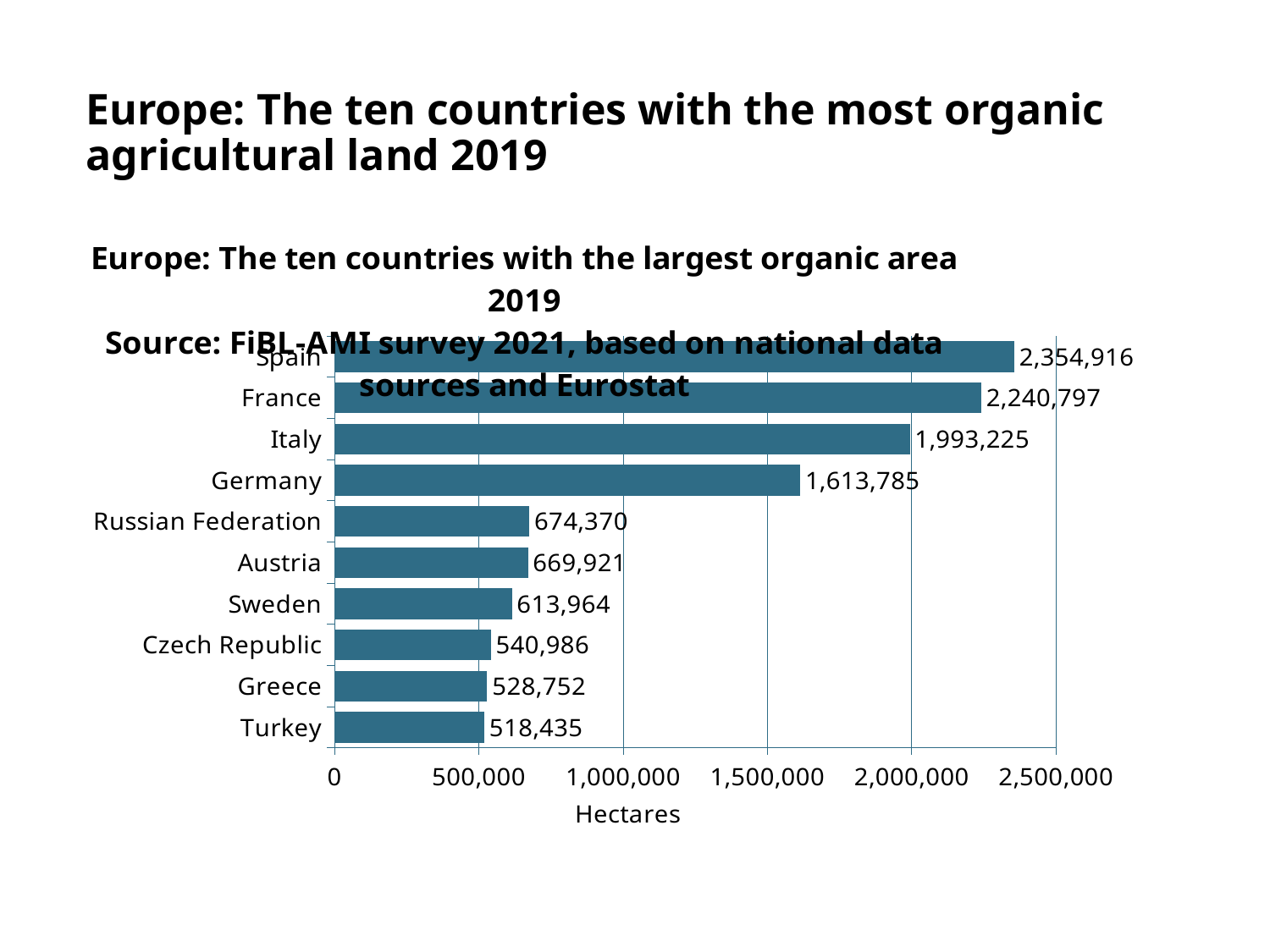
What is the value shown for the Czech Republic? 540,986 What is the value shown for Germany? 1,613,785 What is the difference between Spain's and France's values? 114,119 What unit is shown on the horizontal axis label? Hectares Which country has the smallest organic area among those shown? Turkey What is the difference between Italy's and Germany's values? 379,440 What is the organic agricultural area for Spain? 2,354,916 What kind of chart is shown on the slide? Bar chart Which country has the largest organic area? Spain Which has a larger organic area, Italy or Germany? Italy How many countries are shown in the chart? 10 Is the value for Germany greater or less than 1,500,000? greater